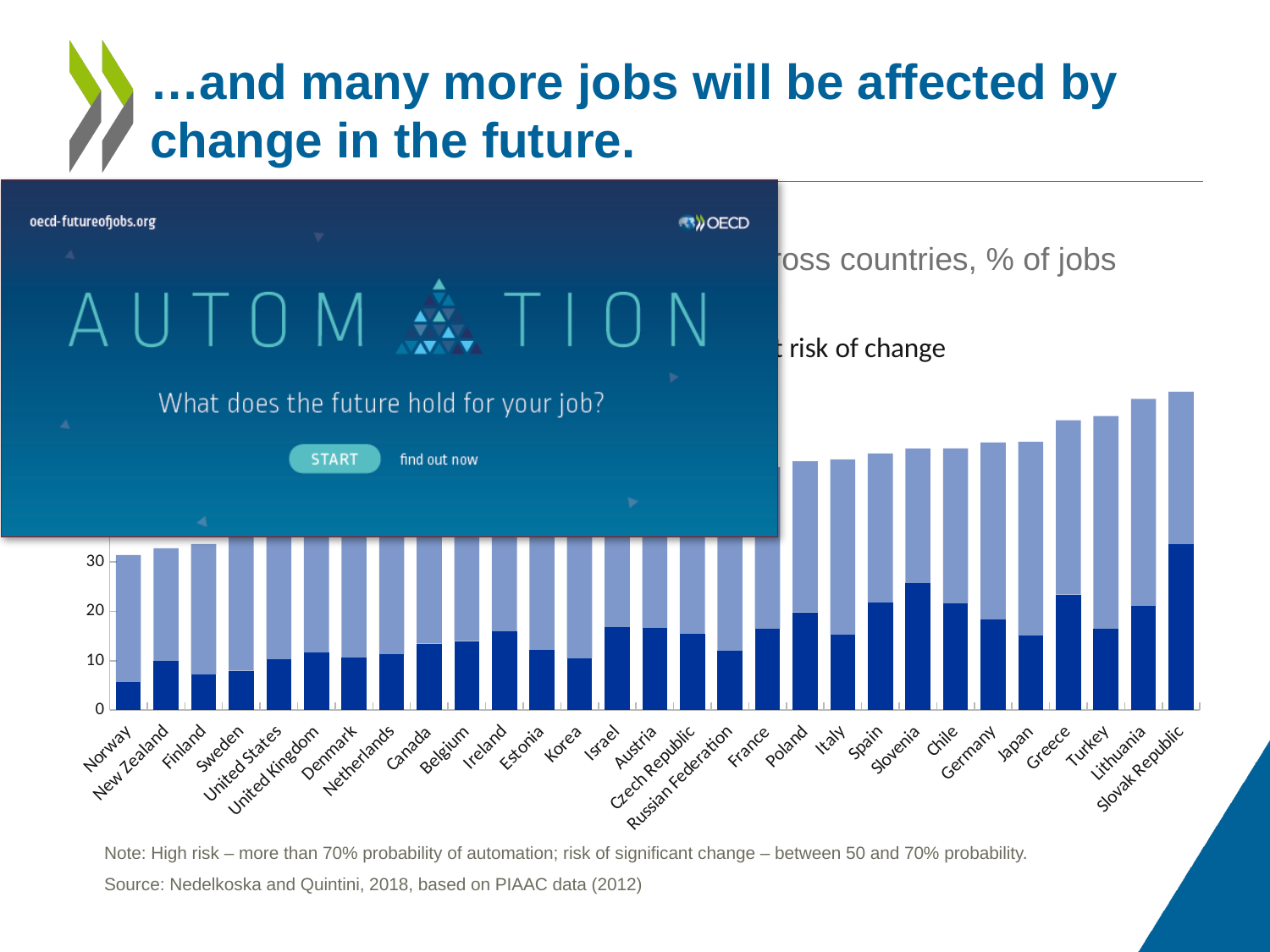
Is the dark blue (high risk) value for Sweden greater or less than 10? less Is the dark blue (high risk) value for Slovenia greater or less than 20? greater How many countries are shown on the x axis of the chart? 29 According to the note on the slide, what probability of automation defines 'high risk'? More than 70% Which has the larger dark blue (high risk) segment, Slovenia or Germany? Slovenia Is the dark blue (high risk) value for Slovak Republic greater or less than 30? greater Which country has the largest dark blue (high risk) segment? Slovak Republic Which country has the tallest total bar in the chart? Slovak Republic Do the total bar heights generally rise or fall from left to right along the x axis? Rise What kind of chart is shown on the slide? Stacked bar chart Which country has the smallest dark blue (high risk) segment? Norway